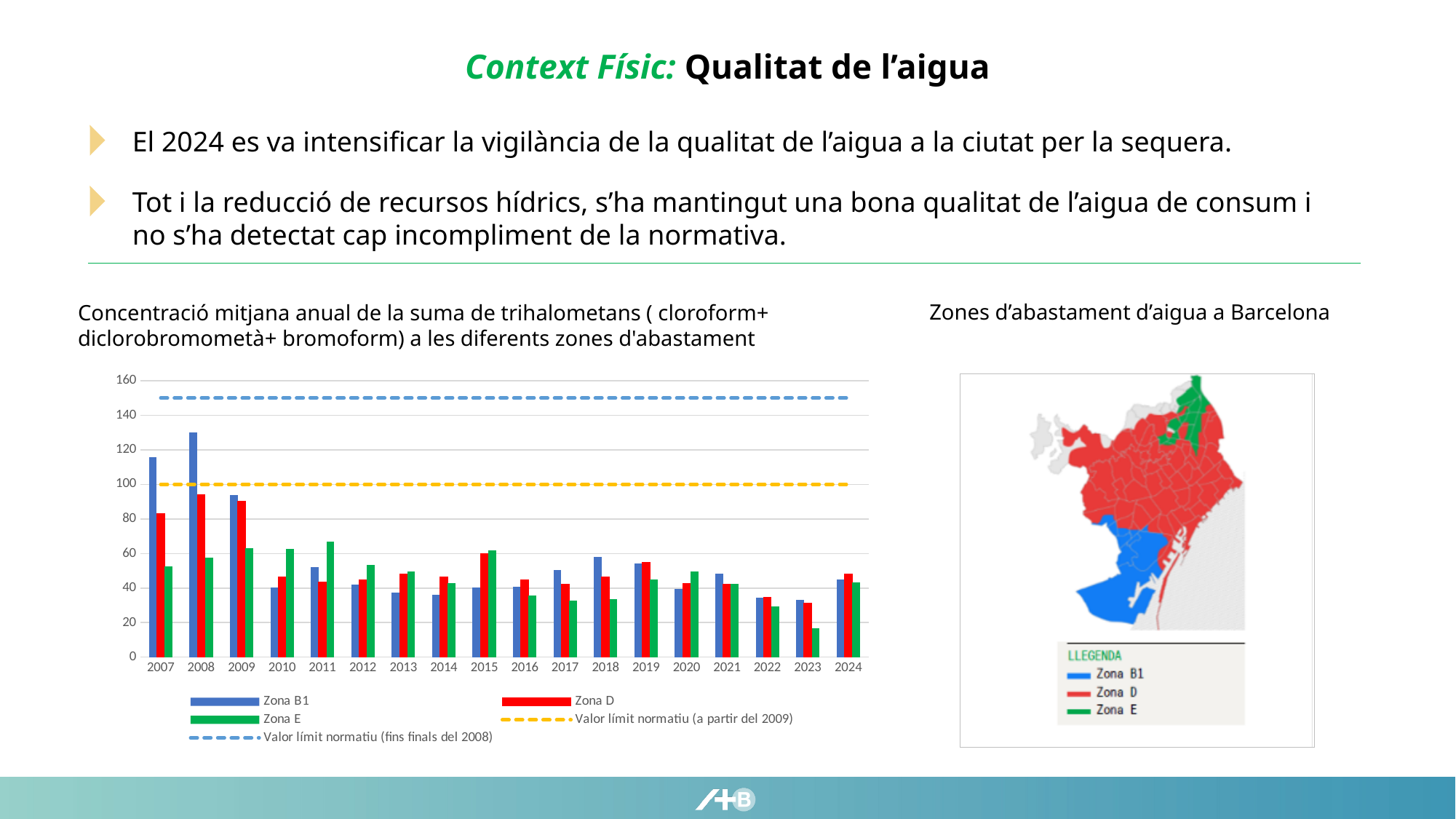
What colour represents Zona D in the trihalomethanes chart? red What kind of chart is used to show the annual mean concentration of trihalomethanes by supply zone? bar chart How many years are shown on the x axis of the trihalomethanes chart? 18 In 2008, which is larger: Zona B1 or Zona D? Zona B1 Do the Zona B1 values rise or fall from 2008 to 2010? fall In which year is the Zona B1 bar highest in the trihalomethanes chart? 2008 How many entries does the legend of the trihalomethanes chart list? 5 In 2010, which is larger: Zona E or Zona B1? Zona E Is the value for Zona B1 in 2007 greater or less than 100? greater Is the value for Zona E in 2023 greater or less than 20? less Is the value for Zona D in 2008 greater or less than 80? greater Which zone has the lowest bar in 2023 in the trihalomethanes chart? Zona E